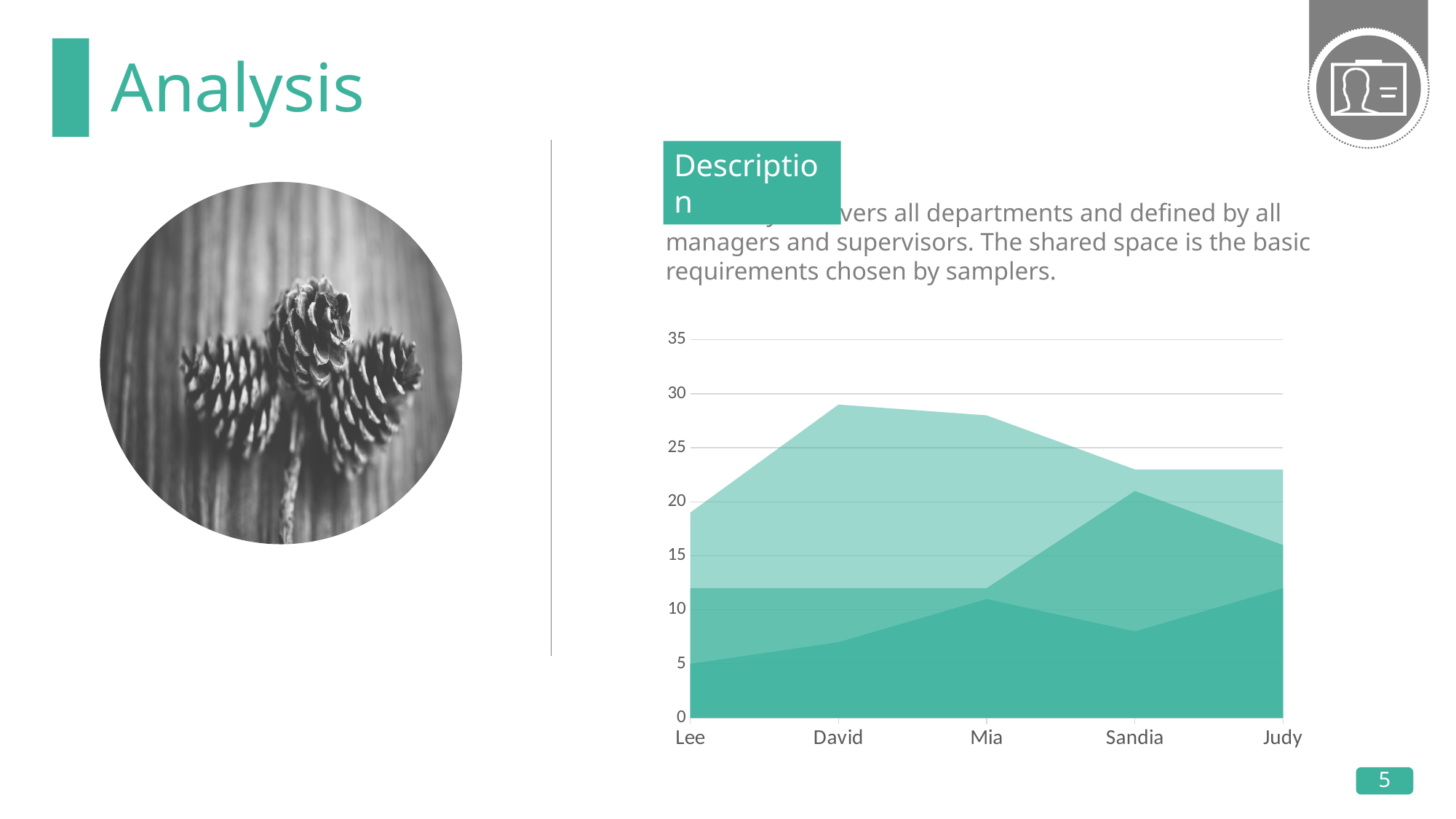
What is the label of the first category on the x axis of the chart? Lee Which category has the lowest total (top of the stacked area) in the chart? Lee Is the value of the bottom (darkest) series for Lee greater or less than 10? less What is the highest value shown on the y axis of the chart? 35 What kind of chart is shown on the slide? Area chart Is the total (top of the stacked area) for Lee greater or less than 15? greater Is the total (top of the stacked area) for Judy greater or less than 20? greater How many categories are shown on the x axis of the chart? 5